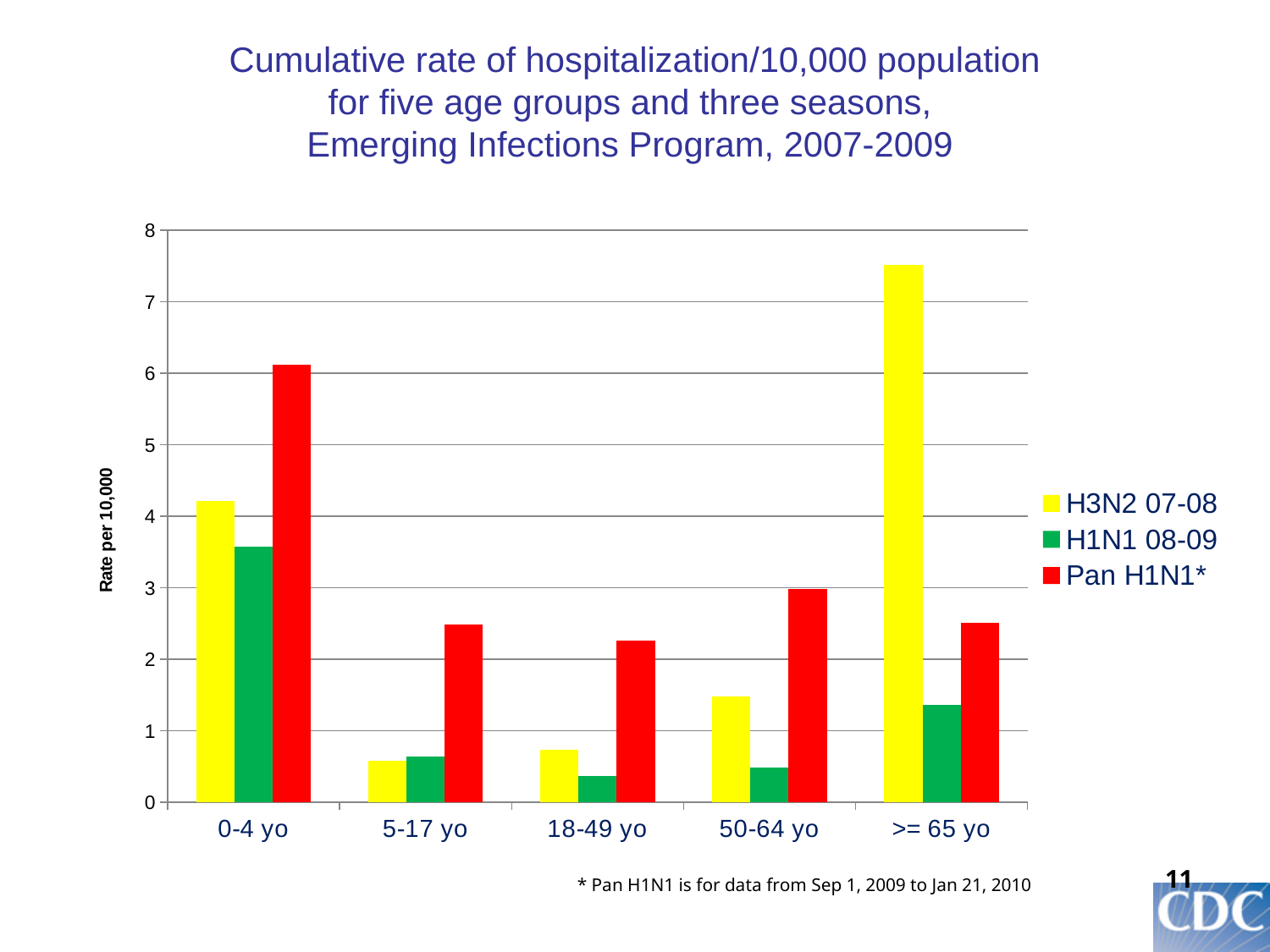
What is the label on the y axis? Rate per 10,000 Which colour represents the Pan H1N1* series in the legend? red What kind of chart is shown on the slide? bar chart For the 0-4 yo group, which is larger: the Pan H1N1* rate or the H3N2 07-08 rate? Pan H1N1* Which age group has the highest Pan H1N1* hospitalization rate? 0-4 yo How many age groups are shown on the x axis? 5 Is the H1N1 08-09 rate for the 18-49 yo group greater or less than 1? less Is the Pan H1N1* rate for the 0-4 yo group greater or less than 6? greater Is the H3N2 07-08 rate for the >= 65 yo group greater or less than 7? greater Which age group has the lowest H1N1 08-09 hospitalization rate? 18-49 yo Which age group has the highest H3N2 07-08 hospitalization rate? >= 65 yo How many series does the legend list? 3